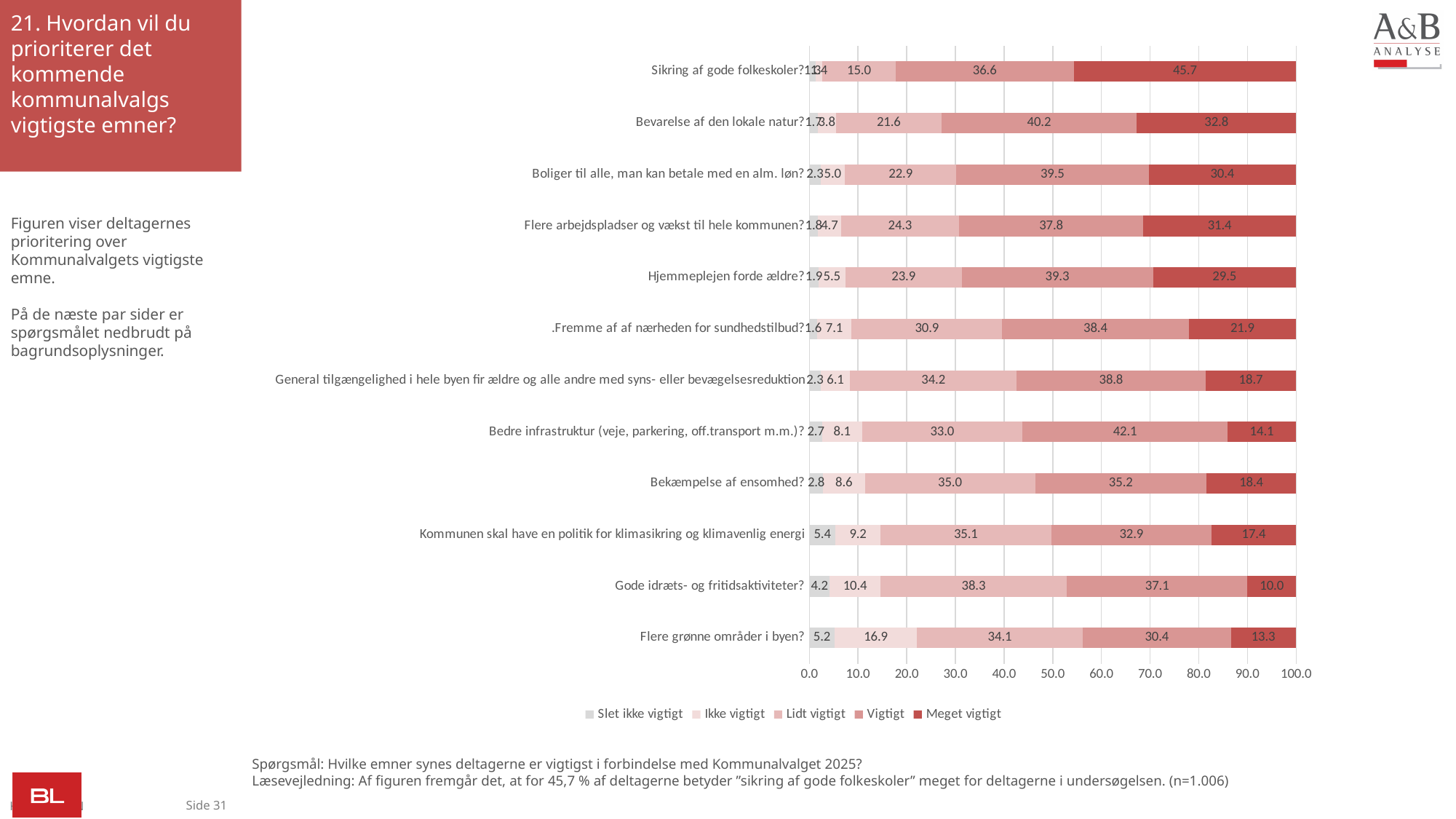
Which category has the lowest value for 'Meget vigtigt'? Gode idræts- og fritidsaktiviteter? How many categories are shown on the chart? 12 What is the value for 'Lidt vigtigt' for 'Gode idræts- og fritidsaktiviteter?'? 38.3 Which has the larger 'Vigtigt' value: 'Bedre infrastruktur (veje, parkering, off.transport m.m.)?' or 'Bevarelse af den lokale natur?'? Bedre infrastruktur (veje, parkering, off.transport m.m.)? Which category has the highest value for 'Meget vigtigt'? Sikring af gode folkeskoler? What is the value for 'Meget vigtigt' for 'Sikring af gode folkeskoler?'? 45.7 What is the value for 'Ikke vigtigt' for 'Flere grønne områder i byen?'? 16.9 What is the difference between the 'Meget vigtigt' values for 'Sikring af gode folkeskoler?' and 'Bevarelse af den lokale natur?'? 12.9 What is the first entry in the chart legend? Slet ikke vigtigt What kind of chart is shown on the slide? Stacked bar chart How many series does the legend list? 5 Which has the larger 'Ikke vigtigt' value: 'Flere grønne områder i byen?' or 'Bekæmpelse af ensomhed?'? Flere grønne områder i byen?